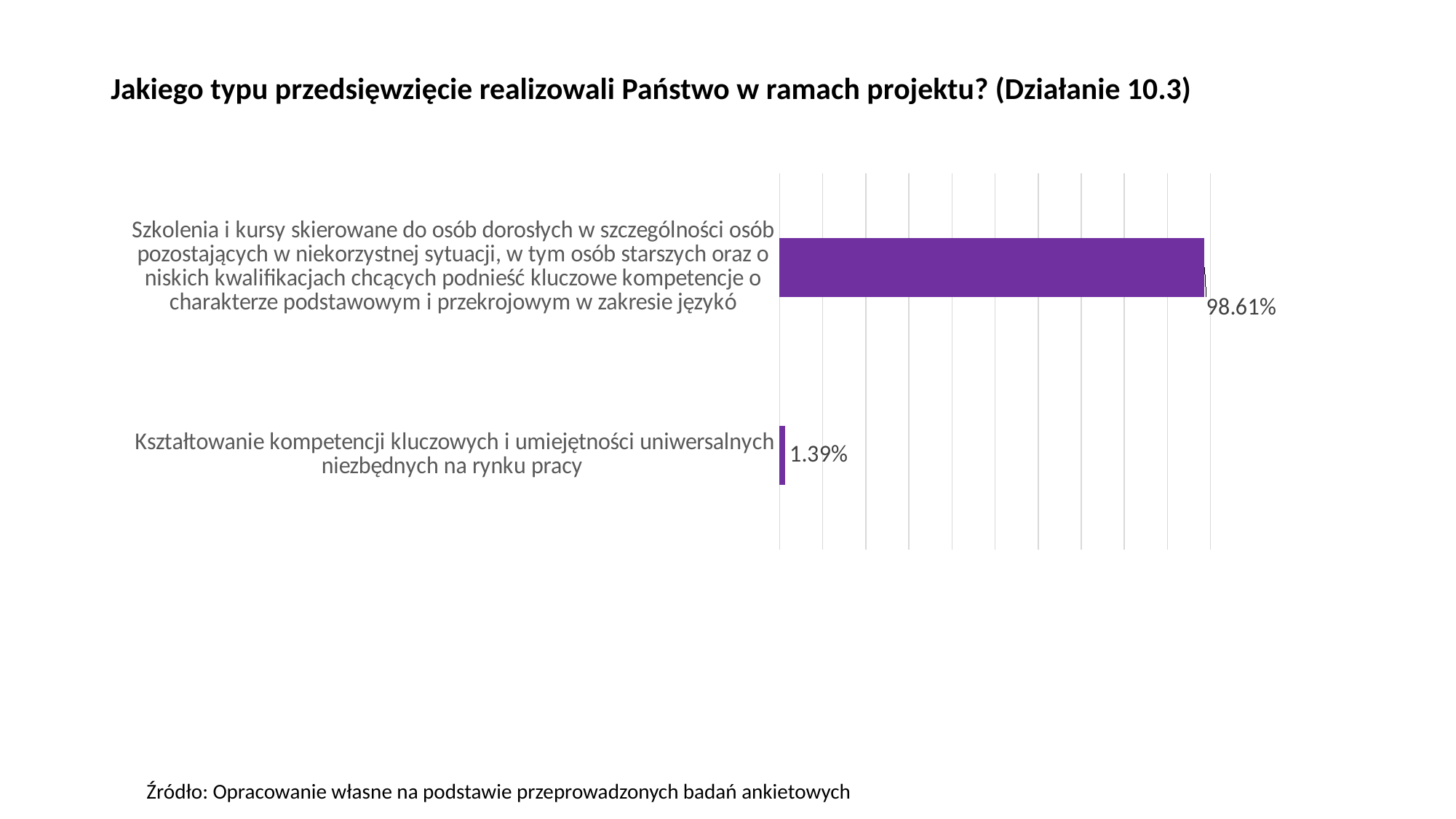
Which category has the highest value? Szkolenia i kursy skierowane do osób dorosłych w szczególności osób pozostających w niekorzystnej sytuacji... What kind of chart is shown on the slide? Bar chart What is the title of the chart? Jakiego typu przedsięwzięcie realizowali Państwo w ramach projektu? (Działanie 10.3) Which category has the lowest value? Kształtowanie kompetencji kluczowych i umiejętności uniwersalnych niezbędnych na rynku pracy What is the difference between the two plotted values? 97.22% How many categories are shown in the chart? 2 What colour are the bars in the chart? Purple Which is larger: the value for "Szkolenia i kursy..." or the value for "Kształtowanie kompetencji kluczowych..."? Szkolenia i kursy... What is the value for the category "Szkolenia i kursy skierowane do osób dorosłych..."? 98.61% What is the total of the two plotted values? 100% What is the value for "Kształtowanie kompetencji kluczowych i umiejętności uniwersalnych niezbędnych na rynku pracy"? 1.39%